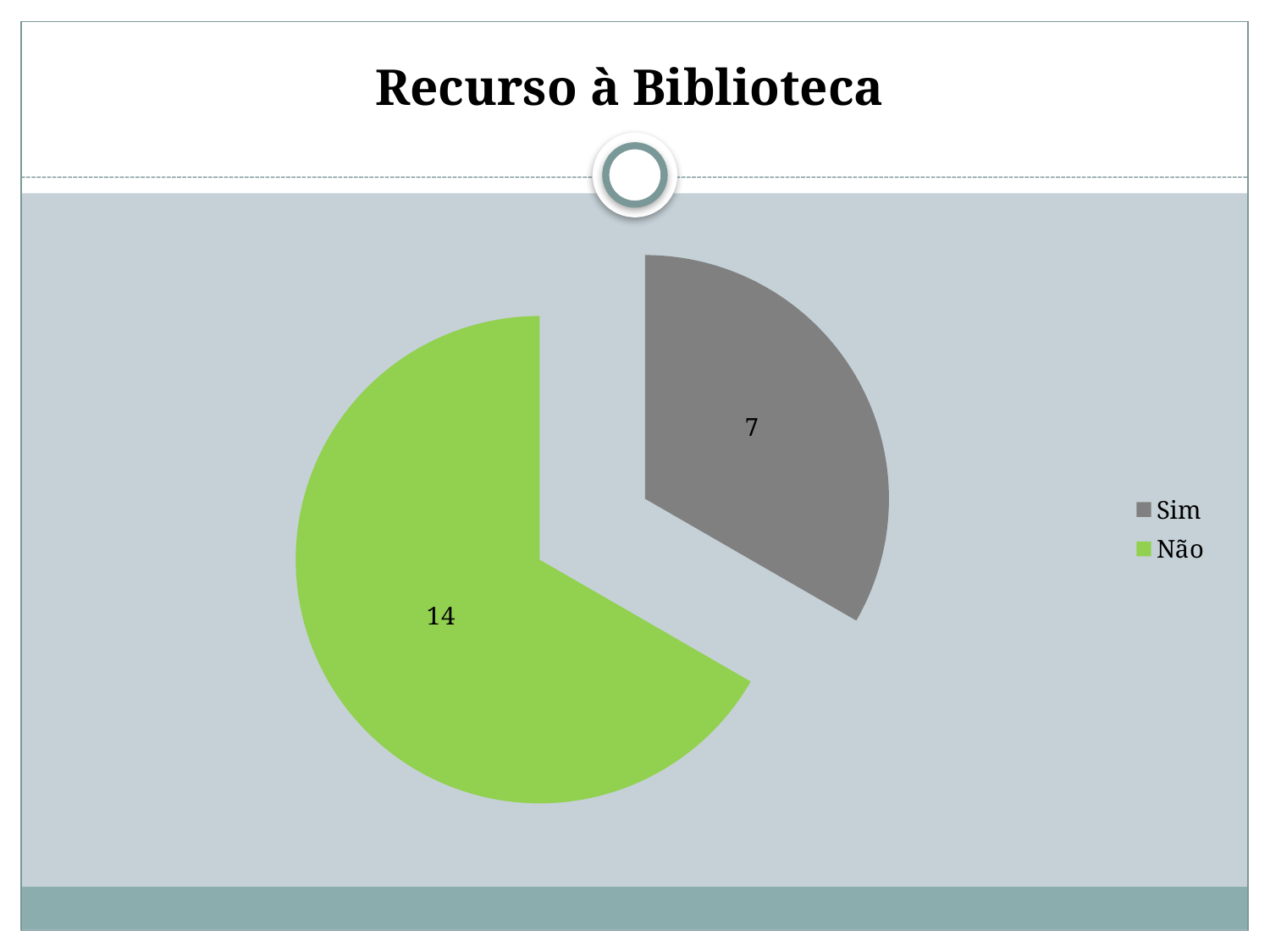
How many entries does the legend list? 2 Which category has the largest slice? Não Which is larger, the value for Sim or the value for Não? Não What is the difference between the values for Não and Sim? 7 What is the total of all slices in the pie chart? 21 How many slices does the pie chart have? 2 What is the value for Sim? 7 What is the title of the slide? Recurso à Biblioteca What is the value for Não? 14 What kind of chart is shown on the slide? Pie chart Which category has the smallest slice? Sim What colour is the Não slice? Green